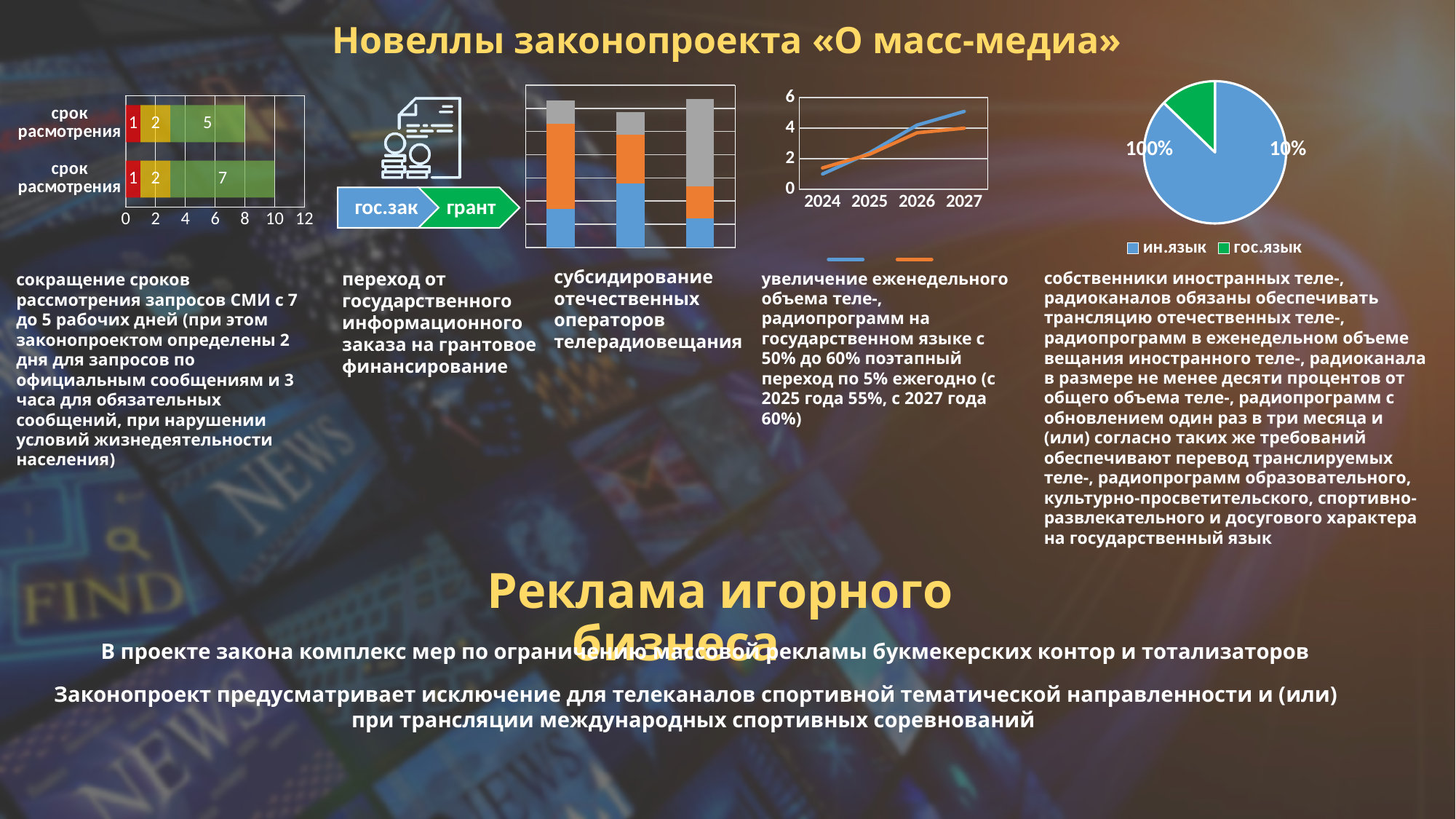
In the line chart with years 2024–2027, do the lines rise or fall from 2024 to 2027? rise In the line chart with years 2024–2027, how many years are shown on the x axis? 4 In the leftmost bar chart, what is the highest value shown on the horizontal axis? 12 What kind of chart is the leftmost chart on the slide (the one with 'срок рассмотрения' labels)? bar chart How many bars are in the stacked bar chart second from the left (blue, orange and gray segments)? 3 How many series does the legend of the pie chart list? 2 In the leftmost bar chart, what is the total of the bottom stacked bar? 10 In the line chart with years 2024–2027, is the value of the blue line in 2027 greater or less than 4? greater In the leftmost bar chart, what is the value of the largest (green) segment of the top bar? 5 In the leftmost bar chart, what is the value of the largest (green) segment of the bottom bar? 7 In the leftmost bar chart, what is the difference between the green segments of the bottom bar and the top bar? 2 In the leftmost bar chart, what is the total of the top stacked bar? 8